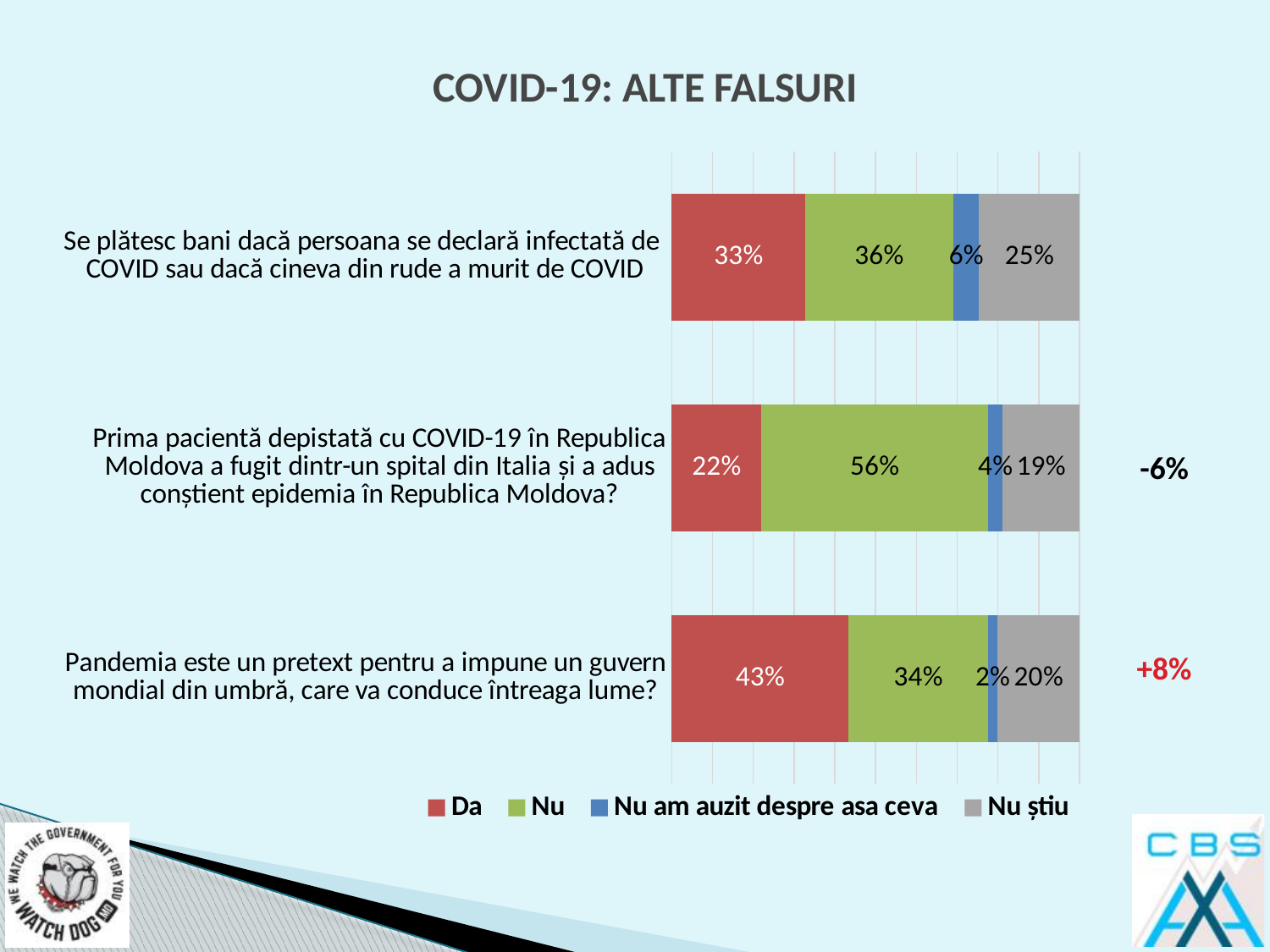
What percentage answered "Da" to the statement "Pandemia este un pretext pentru a impune un guvern mondial din umbră, care va conduce întreaga lume?"? 43% Which statement has the lowest "Nu" share? Pandemia este un pretext pentru a impune un guvern mondial din umbră, care va conduce întreaga lume? What percentage answered "Nu" to the statement "Prima pacientă depistată cu COVID-19 în Republica Moldova a fugit dintr-un spital din Italia și a adus conștient epidemia în Republica Moldova?"? 56% What is the title of the slide? COVID-19: ALTE FALSURI What percentage answered "Nu am auzit despre asa ceva" to the statement about the pandemic being a pretext for a world government? 2% What is the difference between the "Nu" share and the "Da" share for the statement about the first COVID-19 patient fleeing a hospital in Italy? 34% What type of chart is shown on the slide? Stacked bar chart How many series does the legend list? 4 How many statements (categories) are shown in the chart? 3 Which statement has the highest "Da" share? Pandemia este un pretext pentru a impune un guvern mondial din umbră, care va conduce întreaga lume? For the statement about money being paid for declaring COVID infection, is the "Da" share or the "Nu" share larger? Nu What percentage answered "Nu știu" to the statement "Se plătesc bani dacă persoana se declară infectată de COVID sau dacă cineva din rude a murit de COVID"? 25%